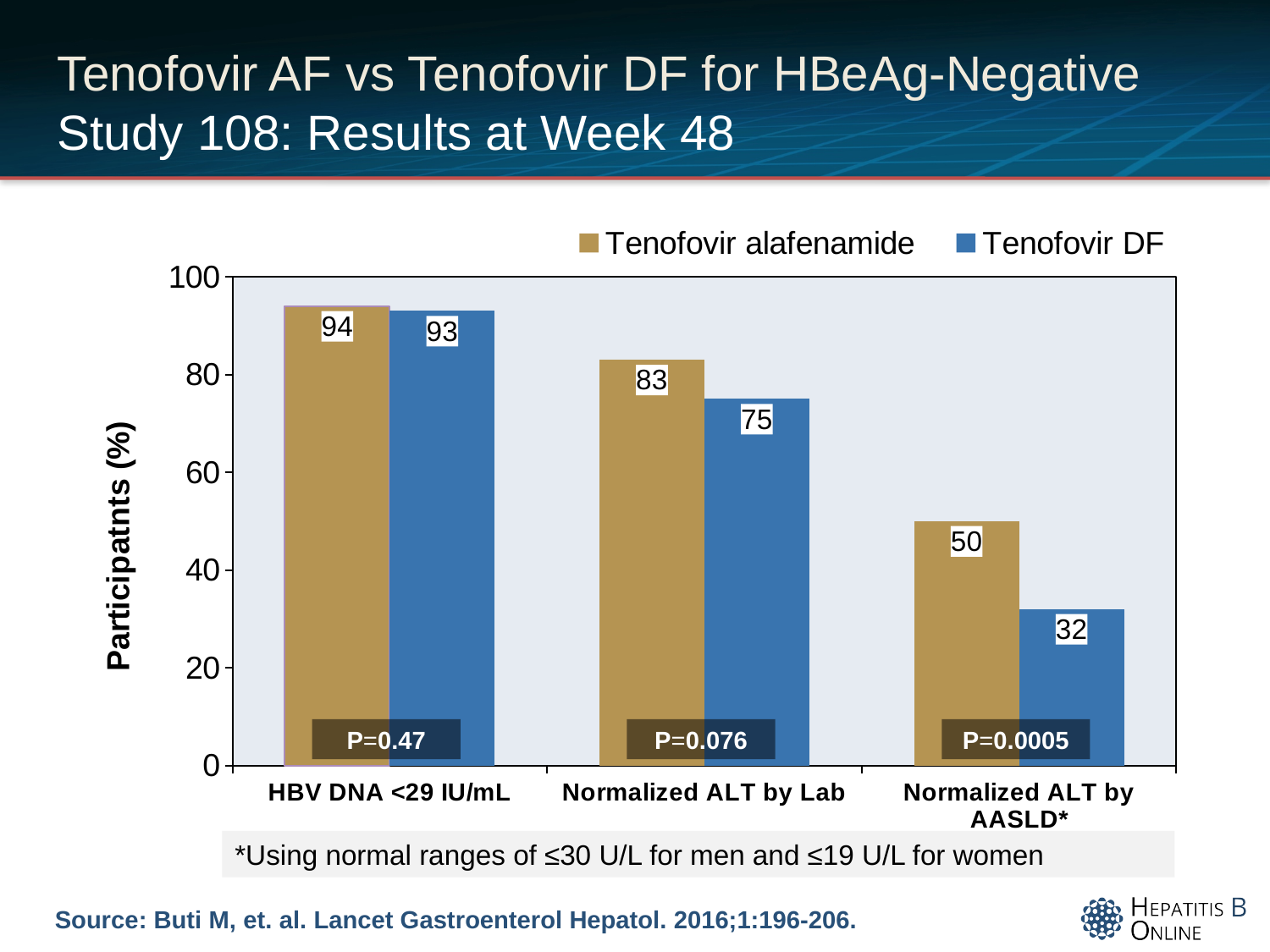
How many series does the legend list? 2 Which category has the highest value for Tenofovir DF? HBV DNA <29 IU/mL What is the difference between Tenofovir alafenamide and Tenofovir DF for Normalized ALT by AASLD*? 18 Which series has the larger value for Normalized ALT by Lab, Tenofovir alafenamide or Tenofovir DF? Tenofovir alafenamide What percentage of participants on Tenofovir DF had normalized ALT by AASLD*? 32 What P value is shown for the HBV DNA <29 IU/mL comparison? P=0.47 What is the value for Tenofovir DF in the Normalized ALT by Lab category? 75 Which category has the lowest value for Tenofovir alafenamide? Normalized ALT by AASLD* What is the difference between Tenofovir alafenamide and Tenofovir DF for Normalized ALT by Lab? 8 How many categories are shown on the x axis? 3 What percentage of participants on Tenofovir alafenamide achieved HBV DNA <29 IU/mL? 94 What kind of chart is shown on the slide? Bar chart